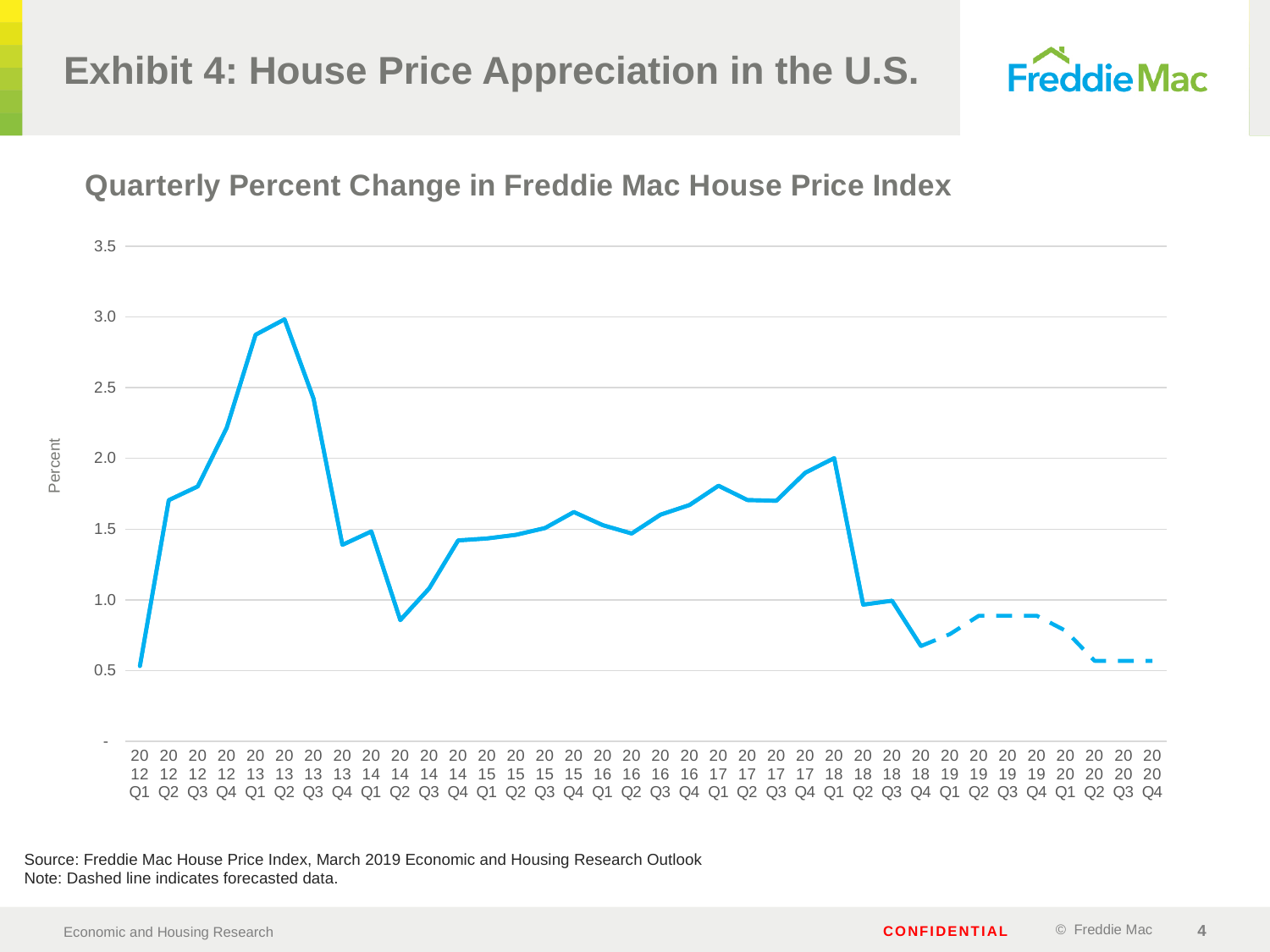
Which is larger, the value for 2014 Q2 or the value for 2014 Q4? 2014 Q4 Is the value for 2018 Q4 greater or less than 1.0? less Is the value for 2013 Q2 greater or less than 2.5? greater What kind of chart is shown on the slide? line chart What is the title of the chart? Quarterly Percent Change in Freddie Mac House Price Index Is the value for 2012 Q1 greater or less than 1.0? less Which quarter has the highest quarterly percent change? 2013 Q2 What does the dashed portion of the line indicate? forecasted data How many quarterly data points are plotted on the chart? 36 Do the values rise or fall from 2018 Q1 to 2018 Q4? fall